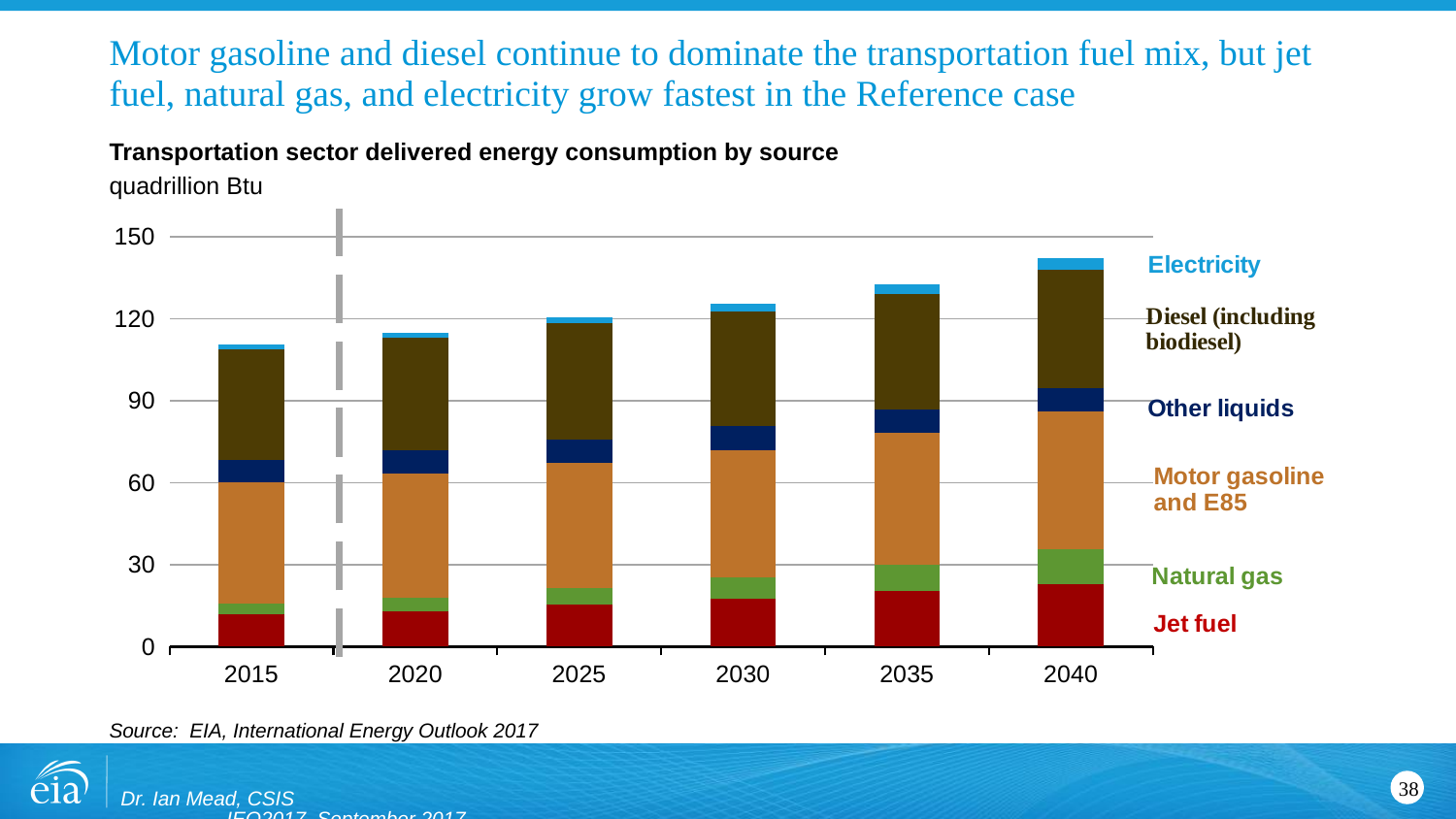
How many fuel sources (series) are labelled on the chart? 6 Which year has the lowest total transportation energy consumption? 2015 Does total transportation energy consumption rise or fall from 2015 to 2040? Rise Is the jet fuel value for 2040 greater or less than 30 quadrillion Btu? less Which year has the highest total transportation energy consumption? 2040 What unit is used on the chart's y axis? quadrillion Btu What is the title of the chart? Transportation sector delivered energy consumption by source How many years are shown along the x axis of the chart? 6 What type of chart is shown on the slide? Stacked bar chart Which is larger, the total bar for 2040 or the total bar for 2020? 2040 Is the total bar for 2015 greater or less than 120 quadrillion Btu? less Is the total bar for 2035 greater or less than 120 quadrillion Btu? greater